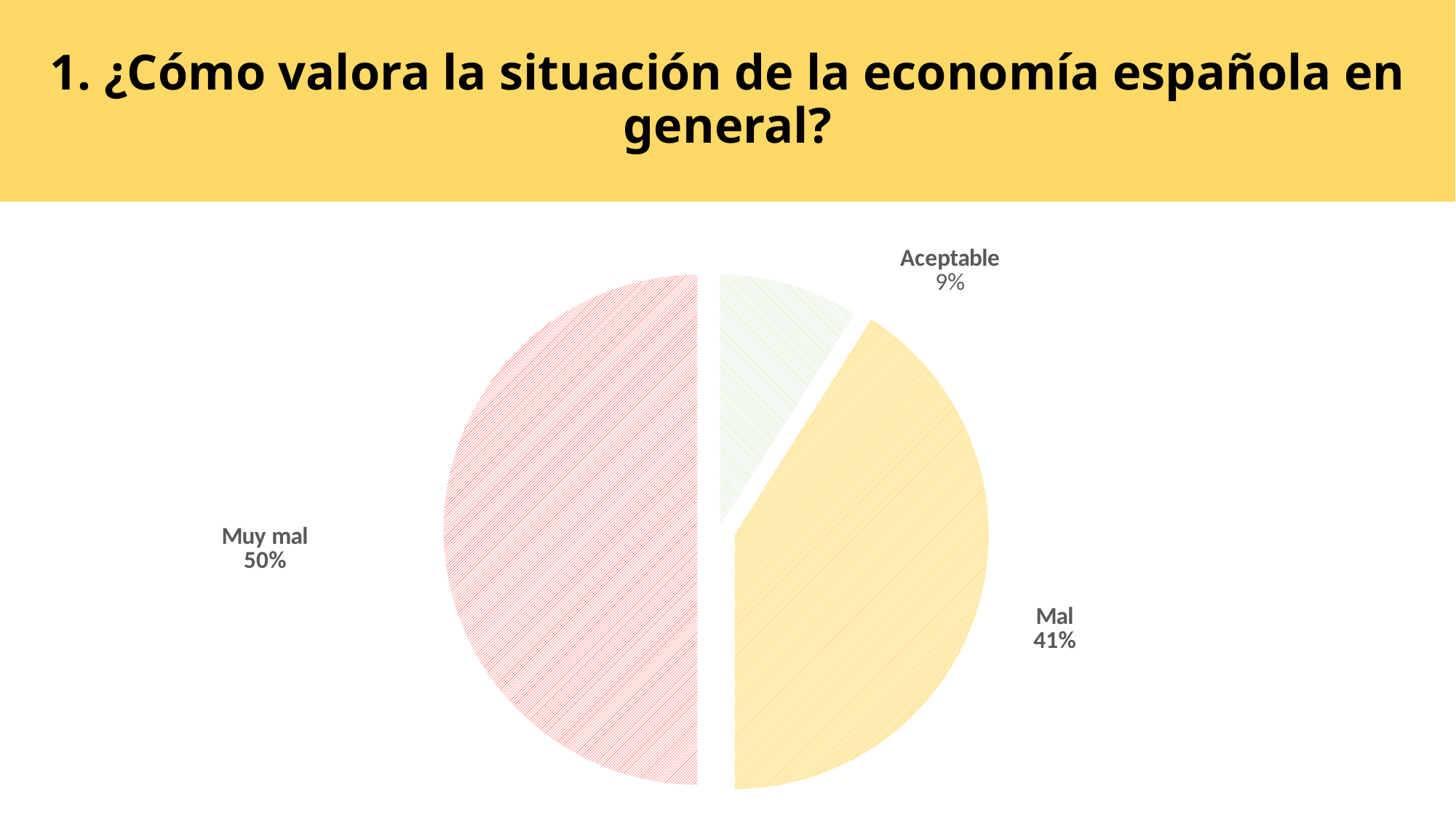
What kind of chart is shown on the slide? pie chart What is the difference in percentage points between "Muy mal" and "Mal"? 9 Which category has the largest slice of the pie? Muy mal How many categories are shown in the pie chart? 3 Which category has the smallest slice of the pie? Aceptable What share of the pie does "Aceptable" represent? 9% What is the combined share of "Muy mal" and "Mal"? 91% Which is larger, the share for "Mal" or the share for "Aceptable"? Mal What is the difference in percentage points between "Mal" and "Aceptable"? 32 What share of the pie does "Mal" represent? 41% What is the title of the slide containing the pie chart? 1. ¿Cómo valora la situación de la economía española en general? What share of the pie does "Muy mal" represent? 50%